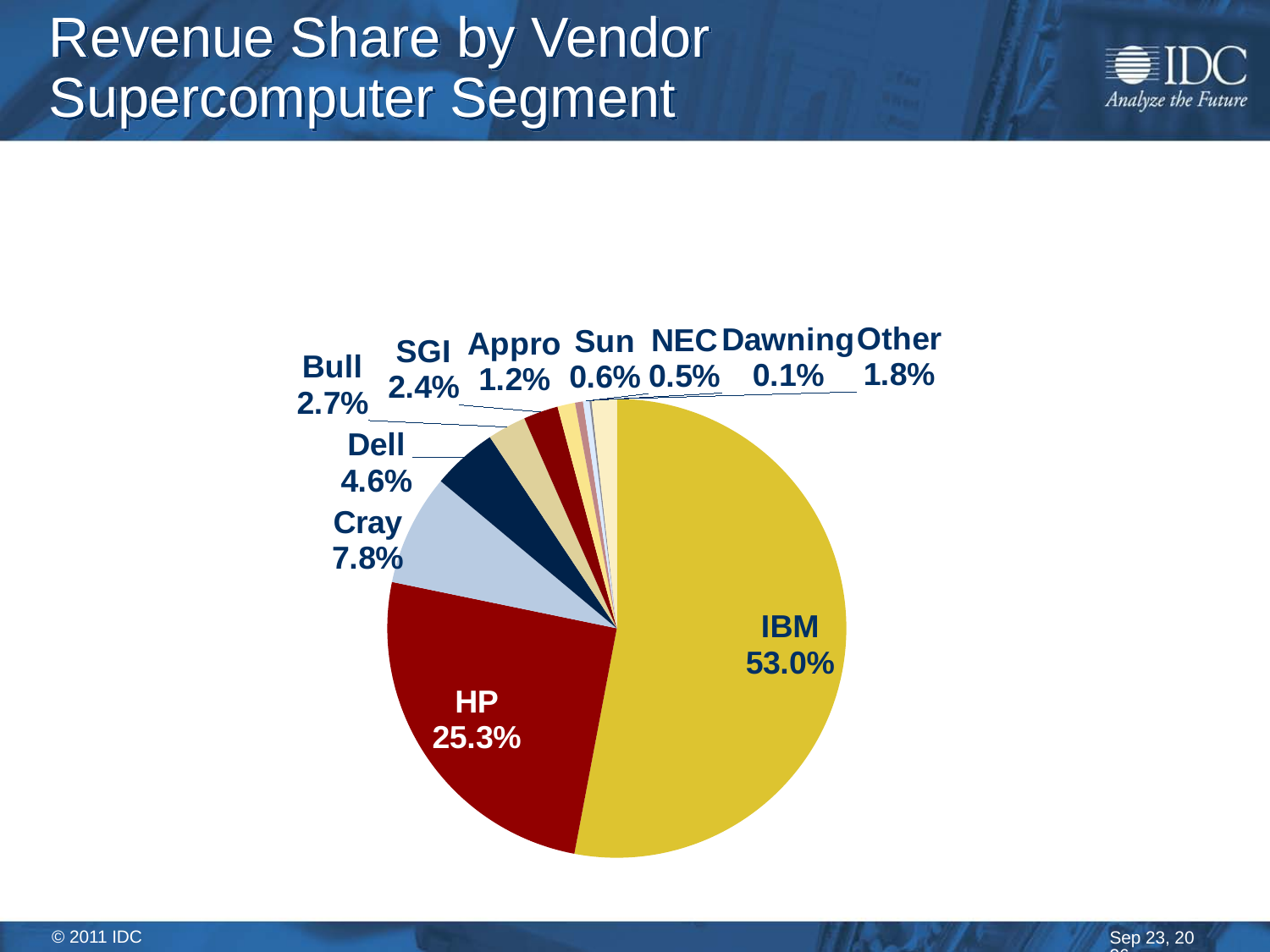
What type of chart is shown on the slide? pie chart What is IBM's revenue share in the supercomputer segment? 53.0% Which has a larger revenue share, Cray or Dell? Cray What is the combined revenue share of Bull and SGI? 5.1% What is Cray's revenue share? 7.8% Which vendor has the largest revenue share? IBM What is HP's revenue share? 25.3% How many slices does the pie chart have? 11 Which vendor has the smallest revenue share? Dawning What is the title of the slide? Revenue Share by Vendor Supercomputer Segment What is the revenue share for Dell? 4.6% What is the difference between IBM's and HP's revenue shares? 27.7%